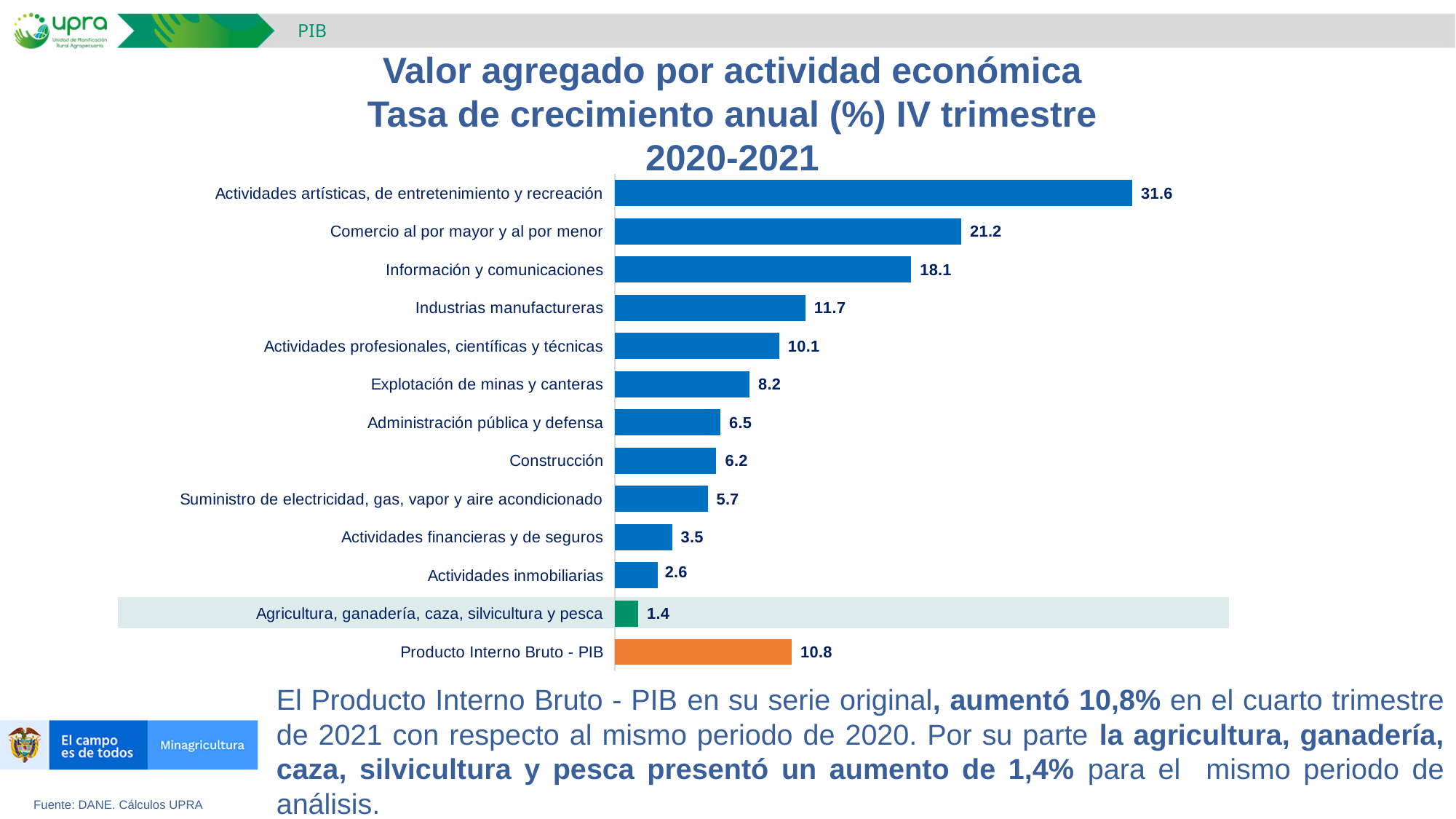
What is the value for Industrias manufactureras? 11.7 Which category has the highest value? Actividades artísticas, de entretenimiento y recreación What is the difference between the value for Producto Interno Bruto - PIB and the value for Agricultura, ganadería, caza, silvicultura y pesca? 9.4 Which category has the lowest value? Agricultura, ganadería, caza, silvicultura y pesca How many categories (bars) are shown in the chart? 13 What kind of chart is shown on the slide? Bar chart What is the value for Agricultura, ganadería, caza, silvicultura y pesca? 1.4 Which is larger, the value for Construcción or the value for Administración pública y defensa? Administración pública y defensa What colour is the bar for Producto Interno Bruto - PIB? Orange What is the value for Actividades artísticas, de entretenimiento y recreación? 31.6 What is the value for Producto Interno Bruto - PIB? 10.8 What is the difference between the values for Comercio al por mayor y al por menor and Información y comunicaciones? 3.1